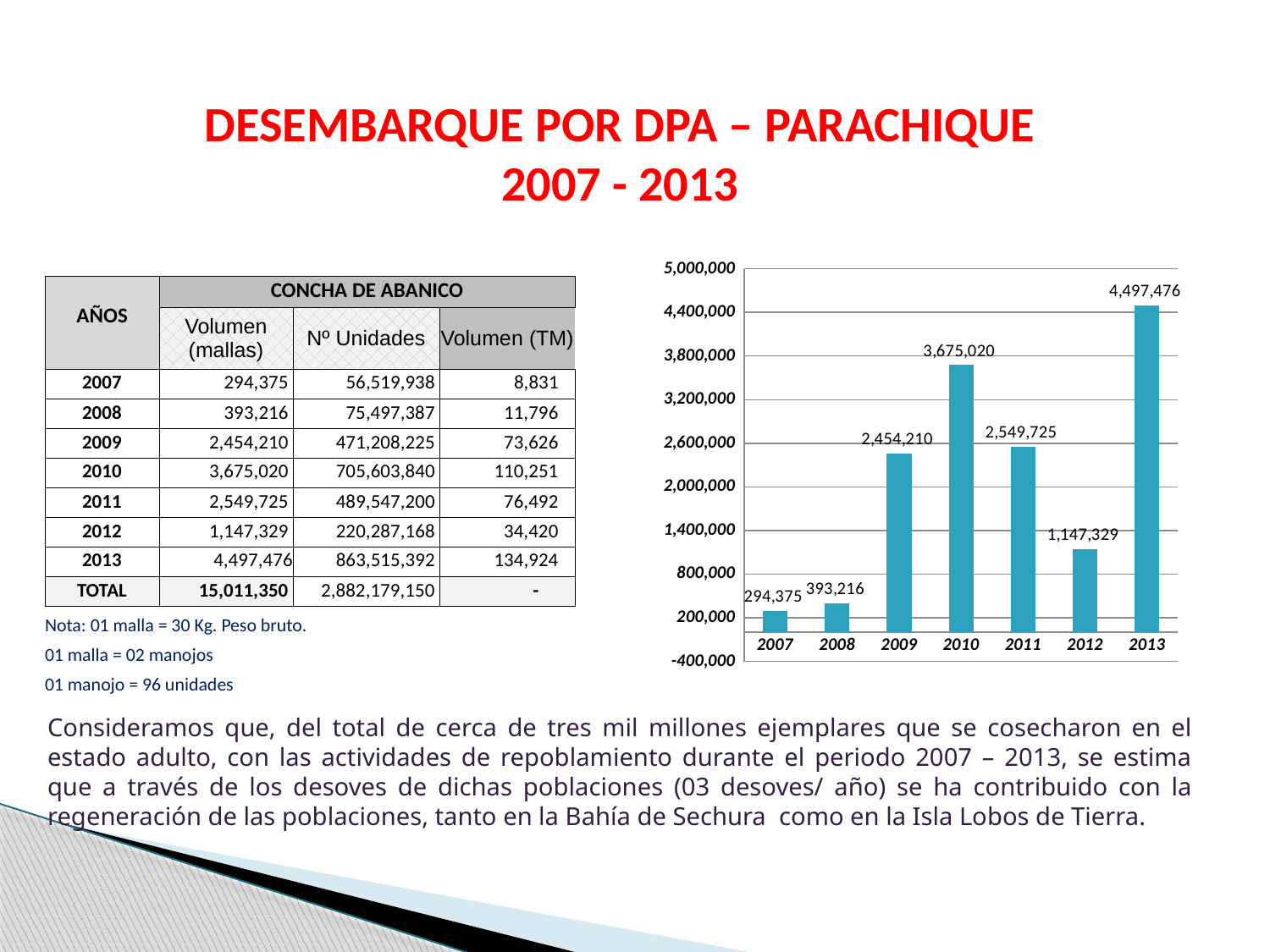
In the bar chart, which is larger, the value for 2011 or the value for 2009? 2011 How many years are plotted in the bar chart? 7 Which year has the highest bar in the chart? 2013 Which year has the lowest bar in the chart? 2007 What kind of chart is shown on the slide? bar chart What is the value shown for 2010 in the bar chart? 3,675,020 What is the difference between the values for 2008 and 2007 in the bar chart? 98,841 What is the value shown for 2012 in the bar chart? 1,147,329 Is the value for 2012 in the bar chart greater or less than 2,000,000? less What is the value shown for 2007 in the bar chart? 294,375 What is the value shown for 2013 in the bar chart? 4,497,476 What is the difference between the values for 2013 and 2010 in the bar chart? 822,456